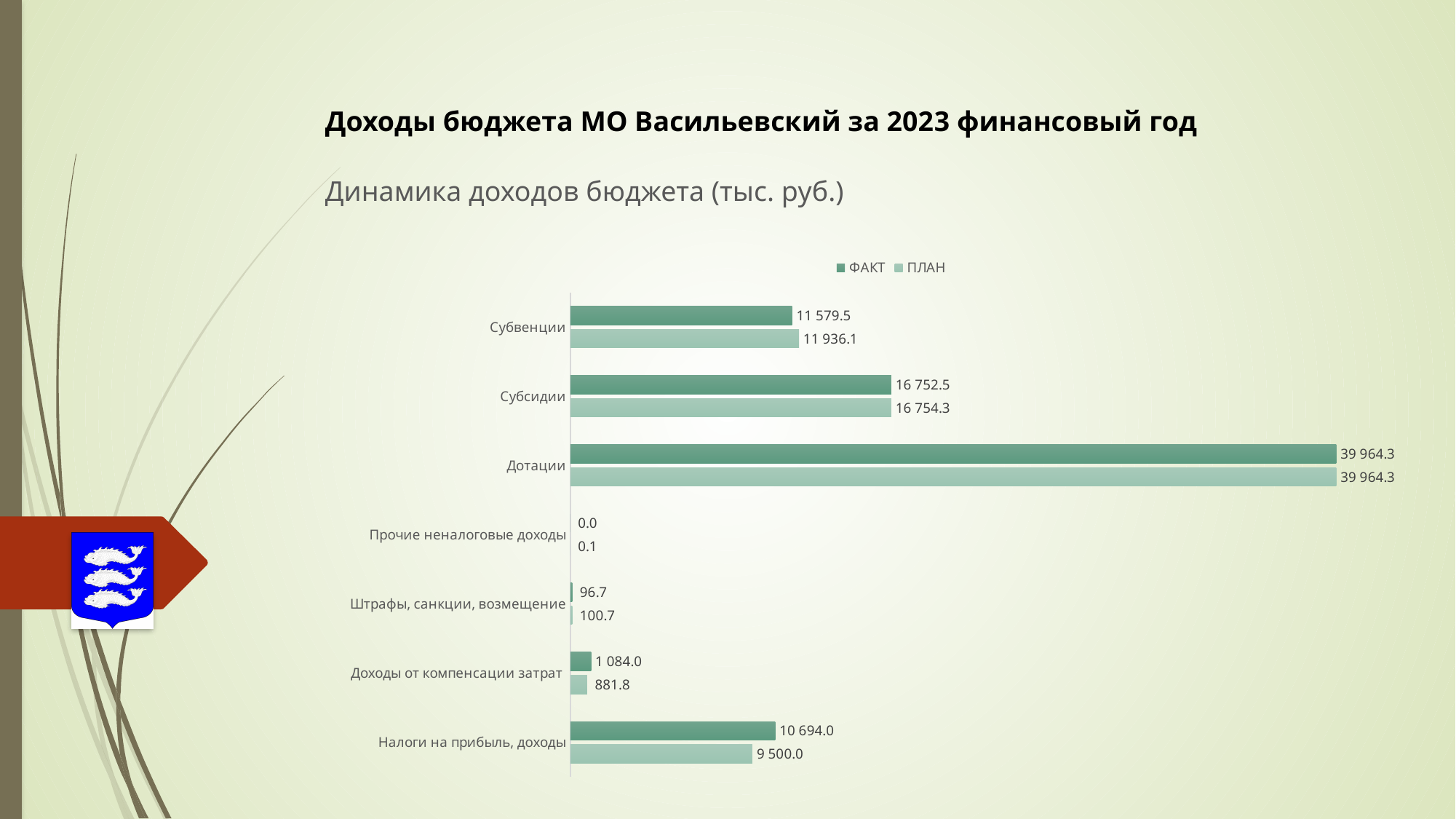
How many series does the chart legend list? 2 How many categories are shown on the chart? 7 For Налоги на прибыль, доходы, which is larger: the ФАКТ value or the ПЛАН value? ФАКТ What kind of chart is shown on the slide? bar chart What is the ФАКТ value for Субвенции? 11 579.5 What is the ПЛАН value for Налоги на прибыль, доходы? 9 500.0 What is the ПЛАН value for Субсидии? 16 754.3 What is the subtitle of the chart shown on the slide? Динамика доходов бюджета (тыс. руб.) Which category has the lowest ПЛАН value? Прочие неналоговые доходы Which category has the highest ФАКТ value? Дотации What is the ФАКТ value for Доходы от компенсации затрат? 1 084.0 What is the difference between the ПЛАН and ФАКТ values for Субвенции? 356.6